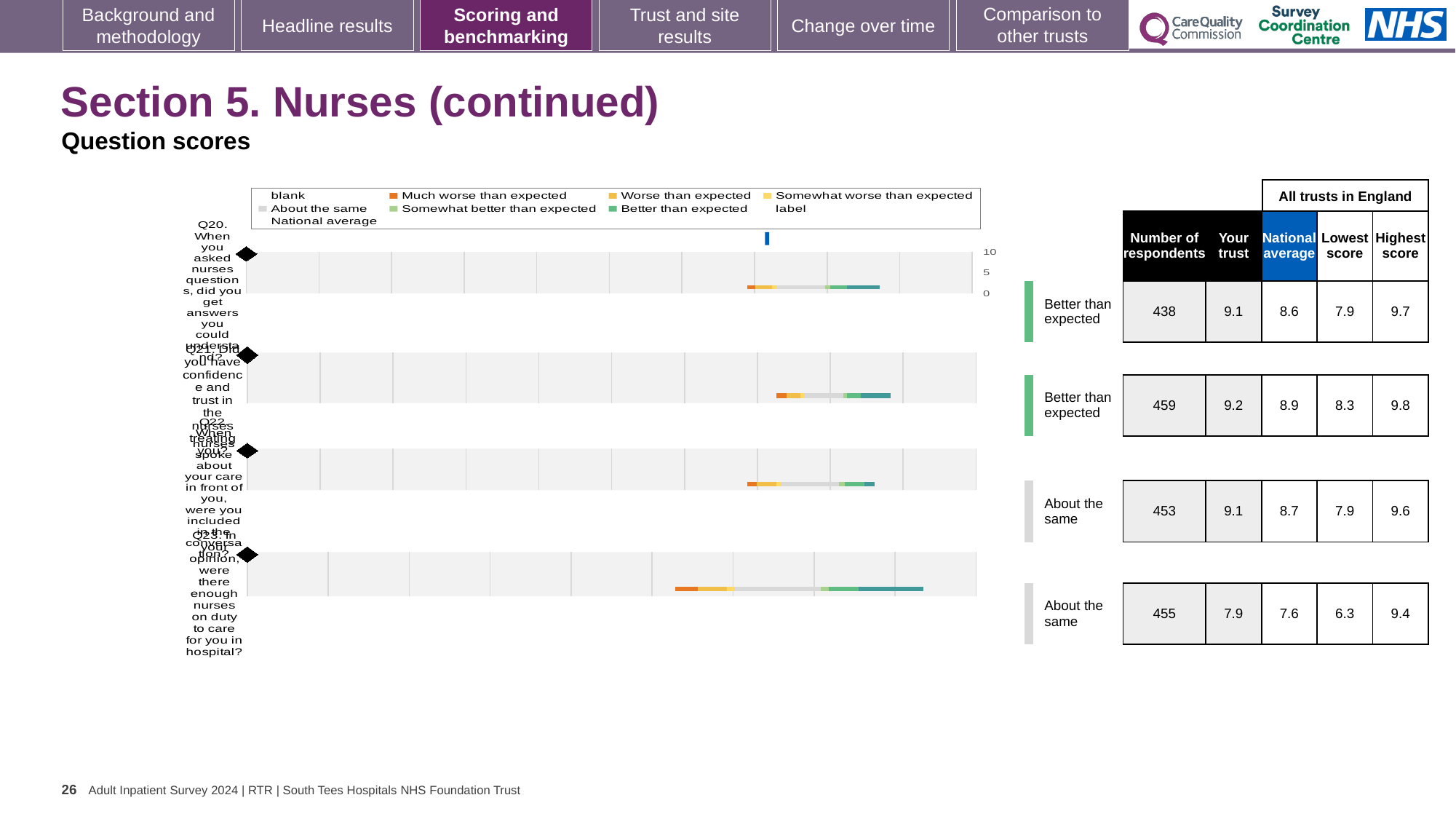
What colour does the legend use for 'Much worse than expected'? orange What is the difference between the 'Your trust' score and the national average for Q23? 0.3 What is the 'Your trust' score for Q21 (confidence and trust in the nurses)? 9.2 What is the highest score across all trusts in England for Q22? 9.6 How many respondents answered Q20? 438 What benchmark category is shown for Q20? Better than expected Which question has the lowest 'Your trust' score? Q23 Which has the larger 'Your trust' score, Q21 or Q23? Q21 Which question has the highest 'Your trust' score? Q21 How many questions (Q20 to Q23) are plotted in the chart? 4 What is the national average score for Q23 (enough nurses on duty)? 7.6 What kind of chart is shown on the slide? bar chart